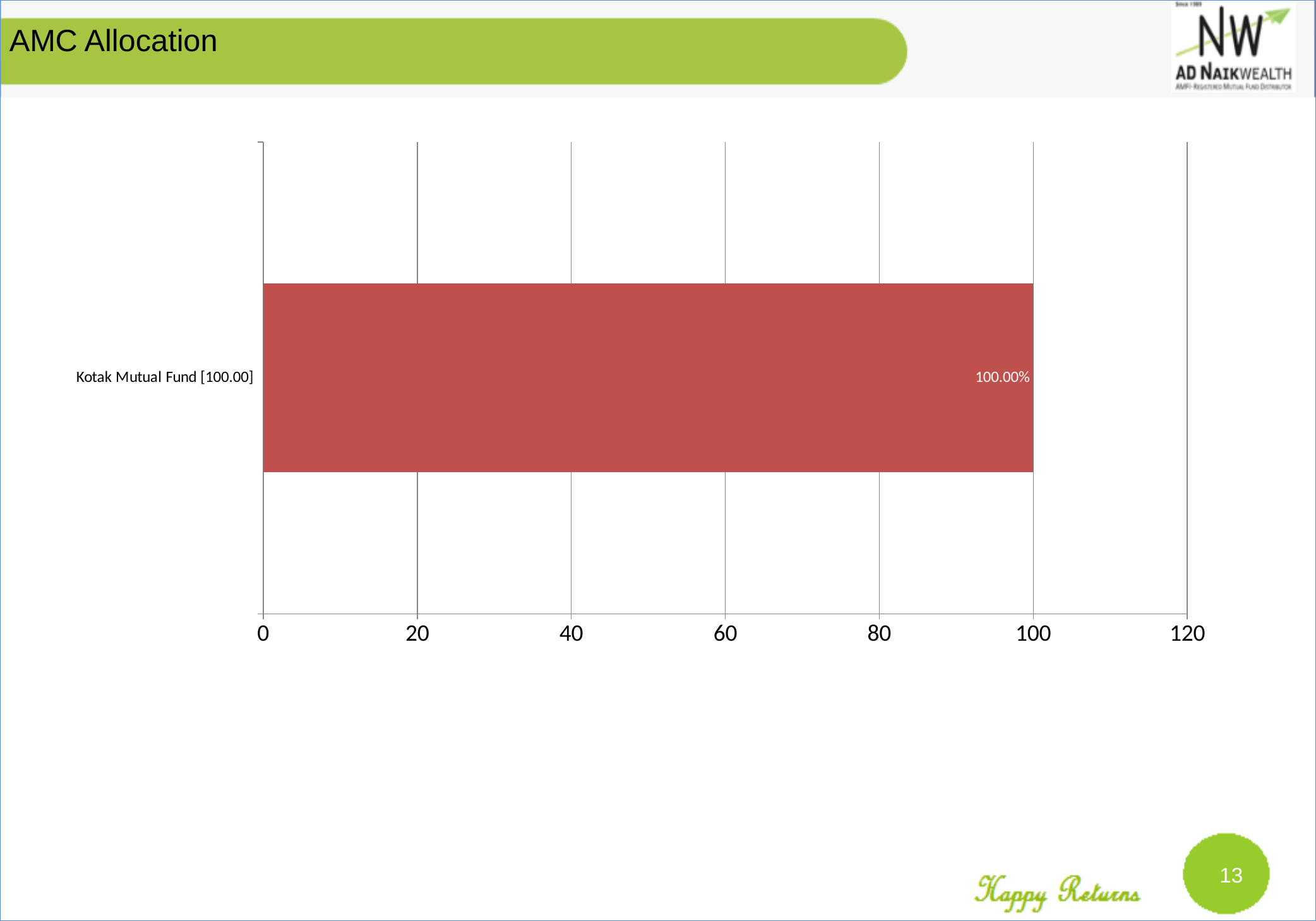
What is the highest value shown on the horizontal axis? 120 What is the value shown for Kotak Mutual Fund? 100.00% Is the value for Kotak Mutual Fund greater or less than 80? greater Which category has the highest value in the chart? Kotak Mutual Fund What is the title of the slide containing the chart? AMC Allocation How many categories are plotted in the chart? 1 Is the value for Kotak Mutual Fund greater or less than 120? less What kind of chart is shown on the slide? bar chart